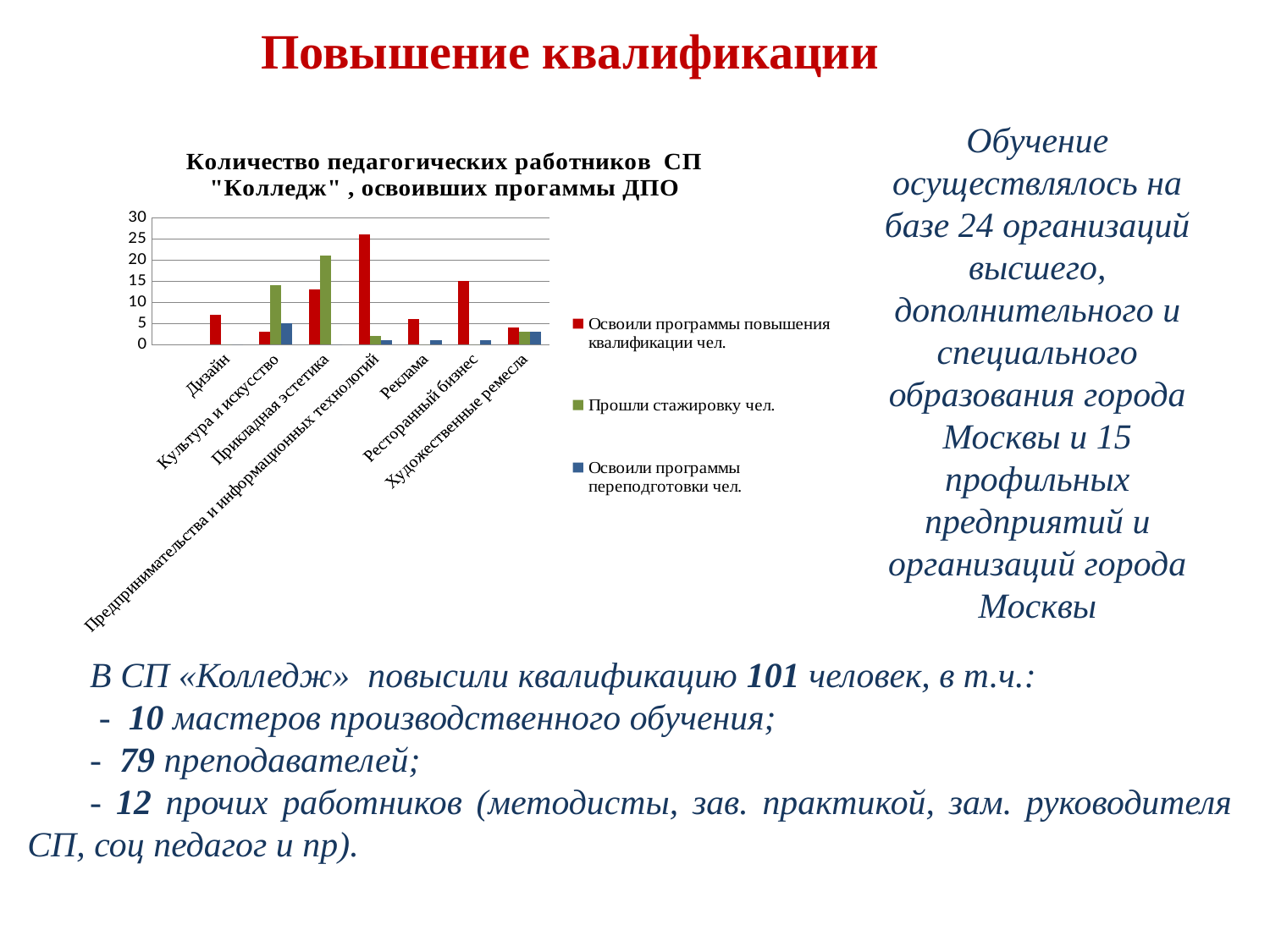
Is the value for "Прикладная эстетика" in the series "Прошли стажировку чел." greater or less than 20? greater Is the value for "Дизайн" in the series "Освоили программы повышения квалификации чел." greater or less than 10? less Which category has the highest value for the series "Прошли стажировку чел."? Прикладная эстетика What is the title of the chart? Количество педагогических работников СП "Колледж" , освоивших прогаммы ДПО Which is larger in the series "Освоили программы повышения квалификации чел.": "Ресторанный бизнес" or "Реклама"? Ресторанный бизнес Which is larger for "Культура и искусство": the value for "Прошли стажировку чел." or the value for "Освоили программы повышения квалификации чел."? Прошли стажировку чел. Which colour represents the series "Прошли стажировку чел." in the chart? green What kind of chart is shown on the slide? bar chart Which category has the highest value for the series "Освоили программы повышения квалификации чел."? Предпринимательства и информационных технологий How many series does the chart legend list? 3 Is the value for "Предпринимательство и информационных технологий" in the series "Освоили программы повышения квалификации чел." greater or less than 25? greater How many categories are shown on the x axis of the chart? 7